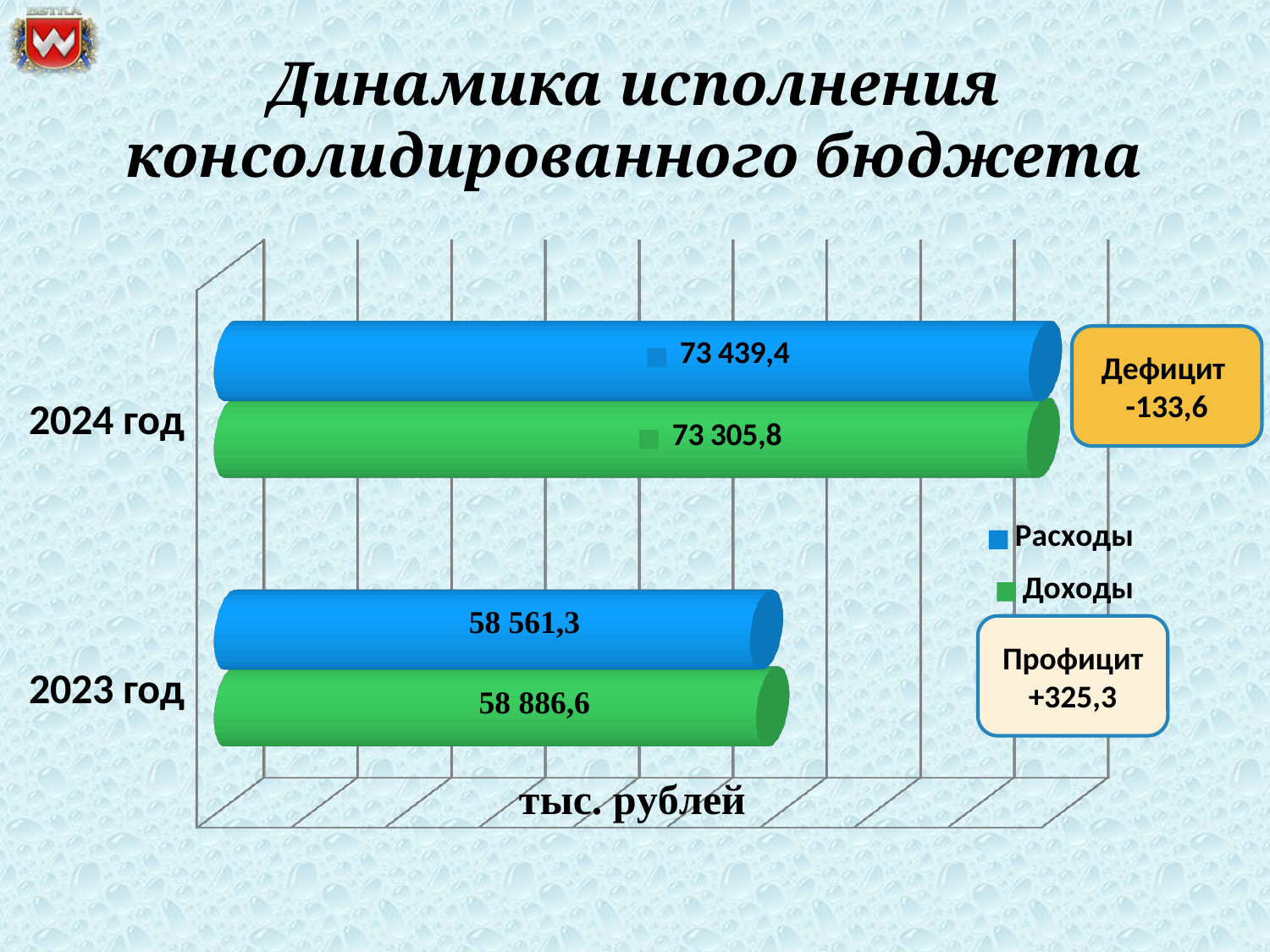
What unit is shown below the chart? тыс. рублей What is the value of Расходы for 2023 год? 58 561,3 Which year has the higher value of Доходы? 2024 год What is the value of Расходы for 2024 год? 73 439,4 What is the value of Доходы for 2023 год? 58 886,6 Which year has the lower value of Расходы? 2023 год For 2023 год, which is larger: Расходы or Доходы? Доходы What is the difference between Расходы and Доходы for 2024 год? 133,6 What kind of chart is shown on the slide? Bar chart How many series does the legend list? 2 What is the difference between Доходы and Расходы for 2023 год? 325,3 What is the value of Доходы for 2024 год? 73 305,8